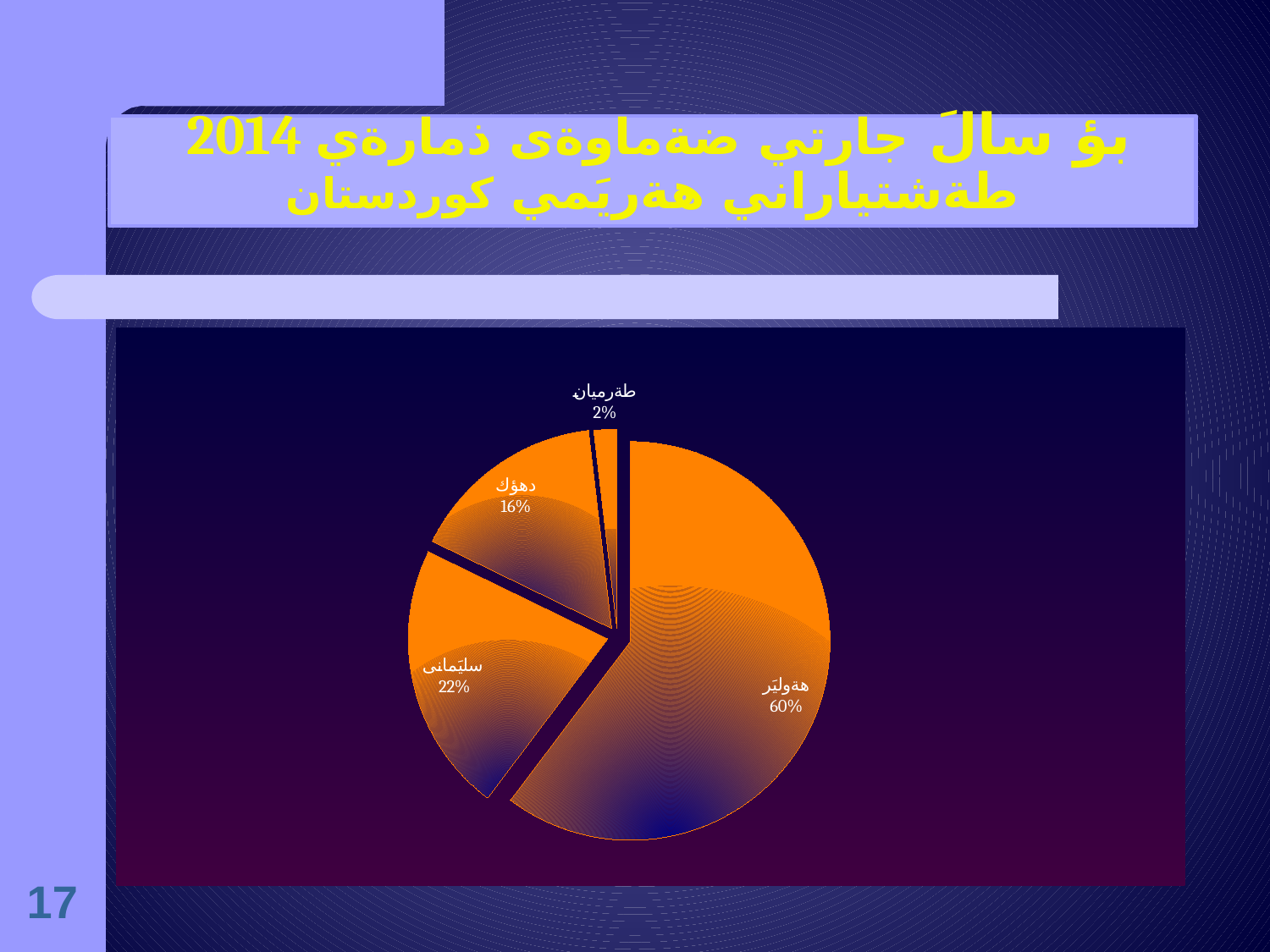
What share of the pie does طةرميان (Garmian) have? 2% What kind of chart is shown on the slide? pie chart What share of the pie does دهؤك (Duhok) have? 16% What share of the pie does سليَمانى (Sulaymaniyah) have? 22% What year is mentioned in the slide title above the pie chart? 2014 Which slice of the pie chart is the smallest? طةرميان (Garmian) What is the combined share of the دهؤك (Duhok) and طةرميان (Garmian) slices? 18% Which is larger, the share for دهؤك (Duhok) or the share for سليَمانى (Sulaymaniyah)? سليَمانى (Sulaymaniyah) What is the difference in percentage points between the هةوليَر (Erbil) slice and the سليَمانى (Sulaymaniyah) slice? 38 What share of the pie does هةوليَر (Erbil) have? 60% Which slice of the pie chart is the largest? هةوليَر (Erbil) How many slices does the pie chart have? 4